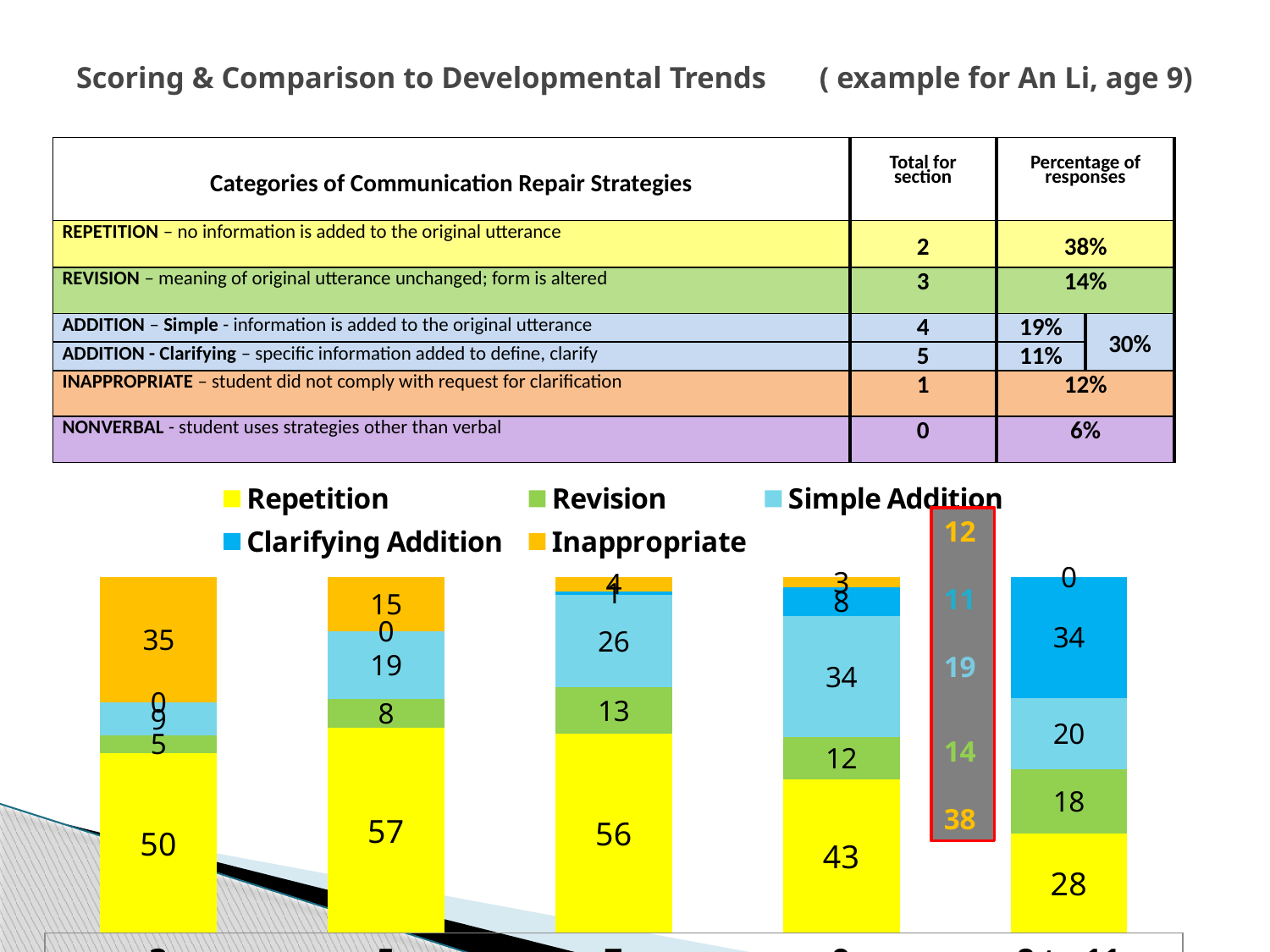
What is the total of the fifth (rightmost) stacked bar? 100 How many series does the chart legend list? 5 What is the Clarifying Addition value in the fifth (rightmost) bar of the chart? 34 What is the Repetition value in the fifth (rightmost) bar of the chart? 28 Which bar has the highest Repetition value? the second bar (57) Which bar has the lowest Repetition value? the fifth bar (28) What is the Repetition value in the first (leftmost) bar of the chart? 50 What is the Inappropriate value in the first (leftmost) bar of the chart? 35 What kind of chart is shown at the bottom of the slide? stacked bar chart How many stacked bars are plotted in the chart? 5 Which has the larger Simple Addition value, the third bar or the fourth bar? the fourth bar What is the difference between the Repetition value in the second bar and the Repetition value in the fifth bar? 29